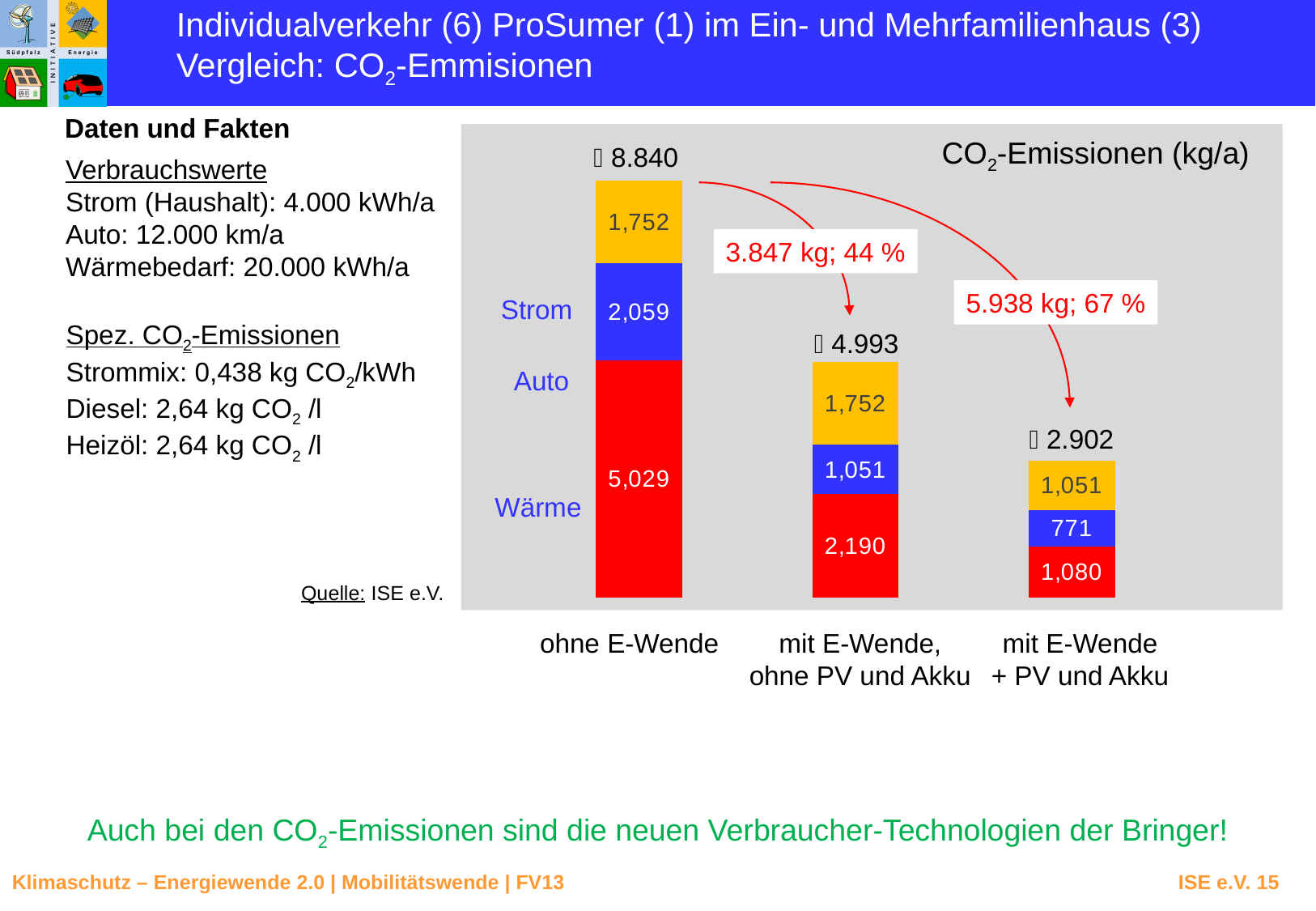
Which scenario has the lowest total CO2 emissions? mit E-Wende + PV und Akku Which scenario has the highest total CO2 emissions? ohne E-Wende What is the value of the yellow segment in the 'mit E-Wende, ohne PV und Akku' bar? 1,752 According to the annotation, by how much do emissions fall from 'ohne E-Wende' to 'mit E-Wende + PV und Akku'? 5.938 kg; 67 % What is the total CO2 emission shown above the 'mit E-Wende + PV und Akku' bar? 2.902 How many bars (scenarios) does the chart show? 3 What kind of chart is shown on the slide? Stacked bar chart Do the total CO2 emissions rise or fall from left to right across the three bars? Fall What is the total CO2 emission shown above the 'ohne E-Wende' bar? 8.840 What is the value of the blue segment in the 'mit E-Wende + PV und Akku' bar? 771 What is the total shown above the 'mit E-Wende, ohne PV und Akku' bar? 4.993 What is the value of the red segment in the 'ohne E-Wende' bar? 5,029